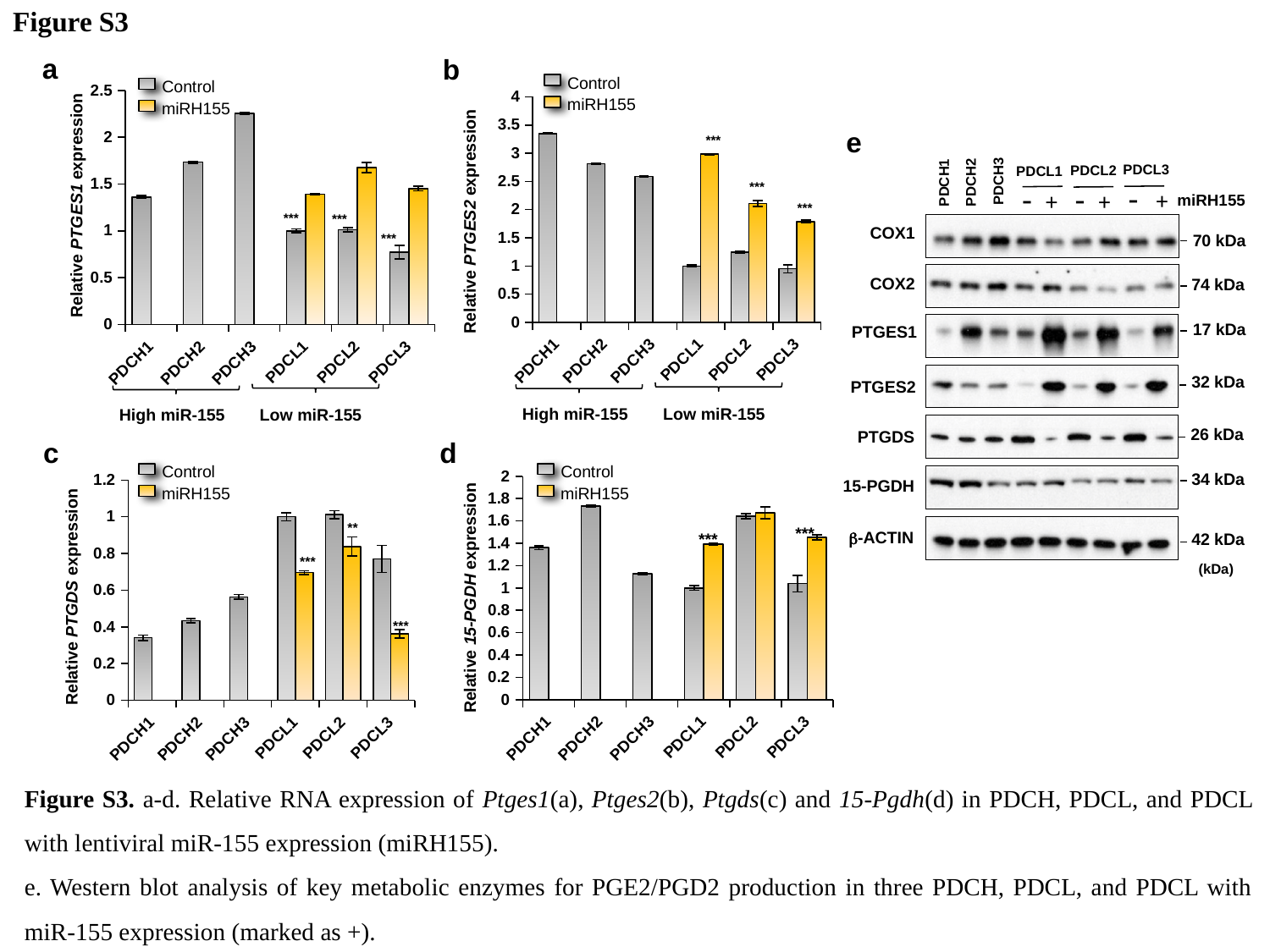
In chart a (Relative PTGES1 expression), how many series does the legend list? 2 In chart c (Relative PTGDS expression), how many categories are shown on the x axis? 6 In chart b (Relative PTGES2 expression), which category has the highest Control bar? PDCH1 In chart c (Relative PTGDS expression), which category has the lowest Control bar? PDCH1 In chart b (Relative PTGES2 expression), for PDCL1, which is larger: the Control bar or the miRH155 bar? miRH155 In chart d (Relative 15-PGDH expression), which category has the highest Control bar? PDCH2 In chart a (Relative PTGES1 expression), which category has the highest Control bar? PDCH3 In chart a (Relative PTGES1 expression), what kind of chart is shown? bar chart In chart a (Relative PTGES1 expression), what are the two group labels shown beneath the x axis? High miR-155 and Low miR-155 In chart c (Relative PTGDS expression), is the miRH155 value for PDCL3 greater or less than 0.6? less In chart b (Relative PTGES2 expression), is the miRH155 value for PDCL1 greater or less than 2.5? greater In chart a (Relative PTGES1 expression), is the Control value for PDCH3 greater or less than 2? greater